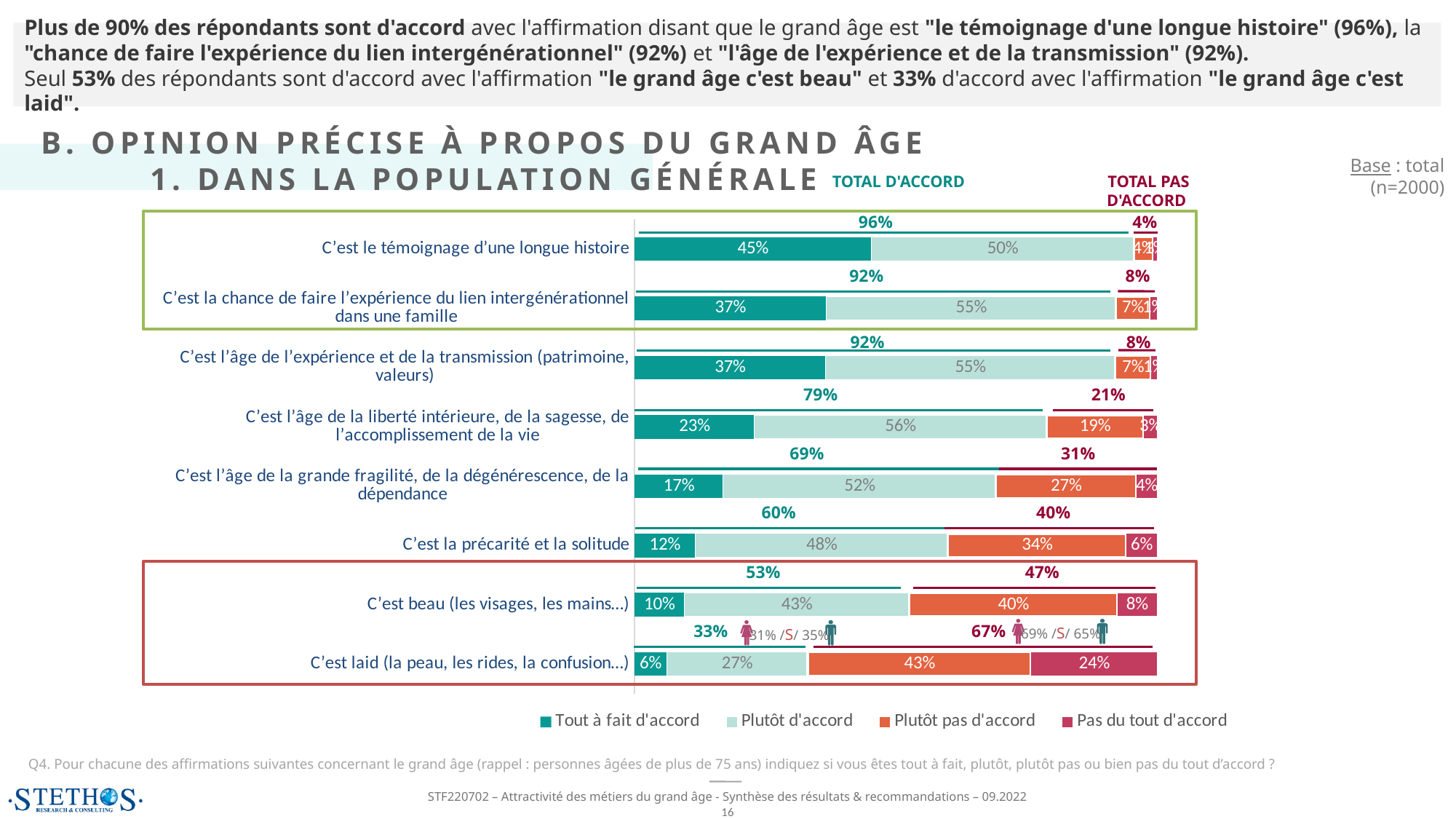
How many statements are shown in the chart? 8 What kind of chart is shown on the slide? Stacked bar chart What is the "Plutôt d'accord" value for "C'est l'âge de la liberté intérieure, de la sagesse, de l'accomplissement de la vie"? 56% What is the "Pas du tout d'accord" value for "C'est laid (la peau, les rides, la confusion…)"? 24% What is the difference between the TOTAL D'ACCORD values for "C'est beau" and "C'est laid"? 20% What is the TOTAL PAS D'ACCORD value for "C'est la précarité et la solitude"? 40% Which statement has the lowest TOTAL D'ACCORD value? C'est laid (la peau, les rides, la confusion…) What is the "Plutôt pas d'accord" value for "C'est beau (les visages, les mains…)"? 40% How many series does the legend list? 4 Which statement has the highest "Tout à fait d'accord" value? C'est le témoignage d'une longue histoire Which is larger: the "Plutôt pas d'accord" value for "C'est la précarité et la solitude" or for "C'est l'âge de la grande fragilité, de la dégénérescence, de la dépendance"? C'est la précarité et la solitude What percentage of respondents answered "Tout à fait d'accord" for "C'est le témoignage d'une longue histoire"? 45%